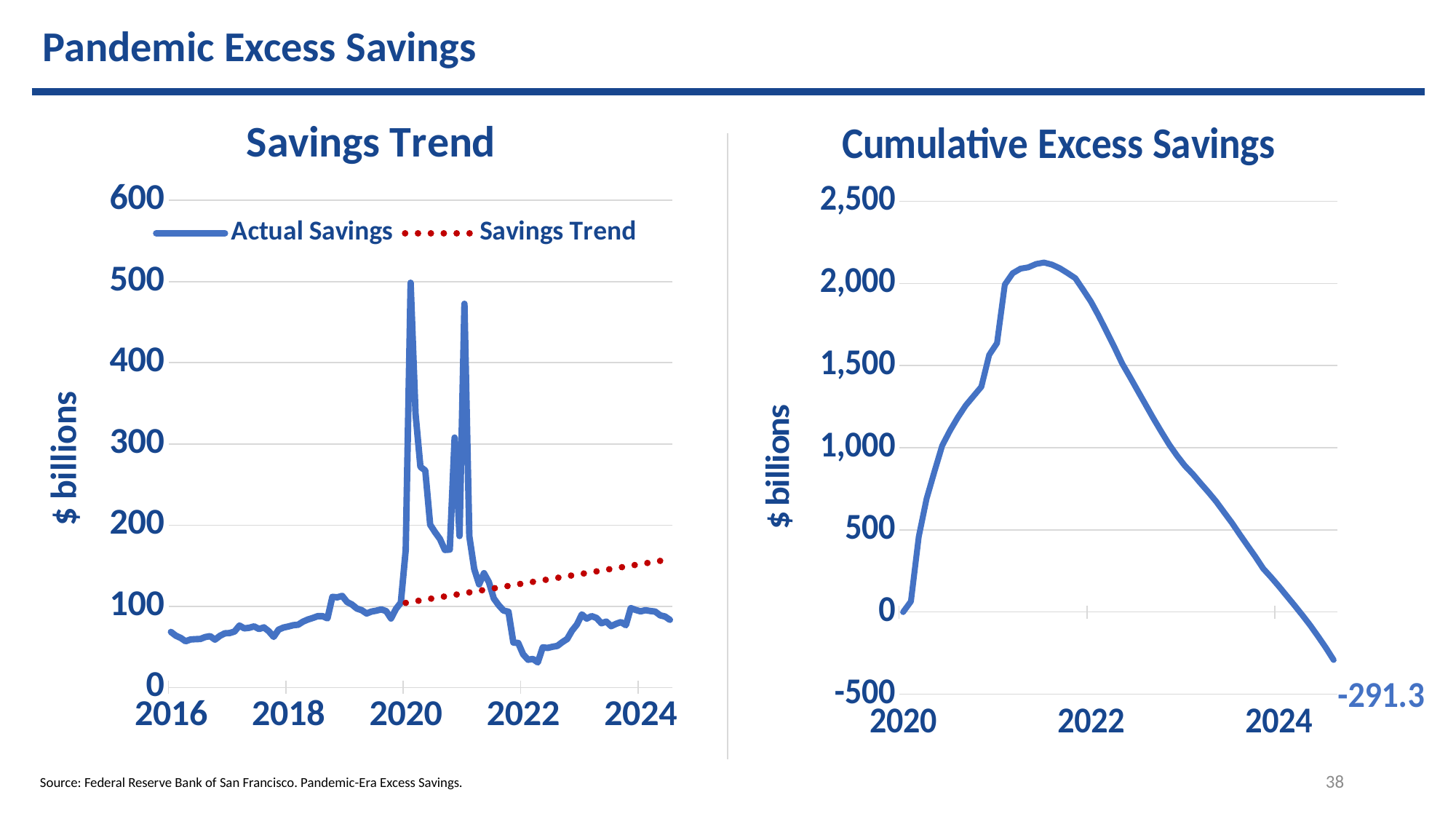
What kind of chart is the Savings Trend chart? line chart In the Savings Trend chart, is the Actual Savings value at 2016 greater or less than 100? less In the Cumulative Excess Savings chart, is the peak value of the line greater or less than 2,000? greater In the Cumulative Excess Savings chart, is the value at 2022 greater or less than 1,500? greater In the Cumulative Excess Savings chart, does the line rise or fall between 2022 and 2024? fall How many series does the legend of the Savings Trend chart list? 2 What kind of chart is the Cumulative Excess Savings chart? line chart In the Savings Trend chart, does the dotted Savings Trend line rise or fall from 2020 to 2024? rise In the Savings Trend chart, which series is drawn as a red dotted line? Savings Trend In the Cumulative Excess Savings chart, what is the value shown by the data label at the end of the line? -291.3 What are the two series named in the legend of the Savings Trend chart? Actual Savings and Savings Trend